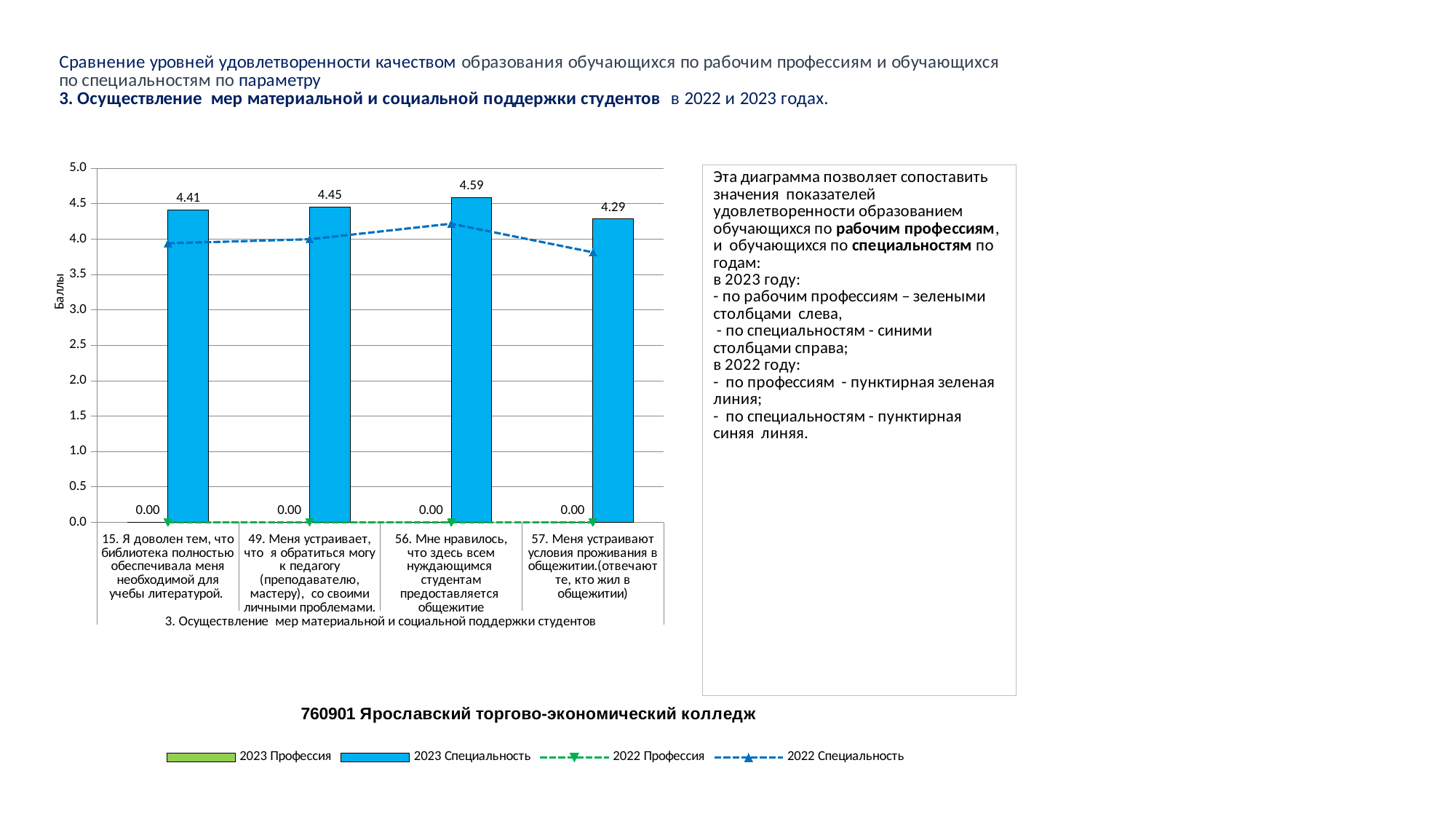
What is the value of the 2023 Специальность bar for category 57 (Меня устраивают условия проживания в общежитии)? 4.29 Is the 2022 Специальность value for category 57 greater or less than 4.0? less How many categories are shown on the x axis? 4 How many series does the legend list? 4 Which category has the highest 2023 Специальность value? 56. Мне нравилось, что здесь всем нуждающимся студентам предоставляется общежитие What is the value of the 2023 Специальность bar for category 56 (Мне нравилось, что здесь всем нуждающимся студентам предоставляется общежитие)? 4.59 What kind of chart is shown on the slide? A combined bar and line chart What is the value of the 2023 Специальность bar for category 15 (Я доволен тем, что библиотека полностью обеспечивала меня необходимой для учебы литературой)? 4.41 What value is labelled for the 2023 Профессия series in category 49? 0.00 Which is larger: the 2023 Специальность value for category 49 or for category 15? Category 49 (4.45) What is the difference between the 2023 Специальность values for category 56 and category 57? 0.30 Which category has the lowest 2023 Специальность value? 57. Меня устраивают условия проживания в общежитии